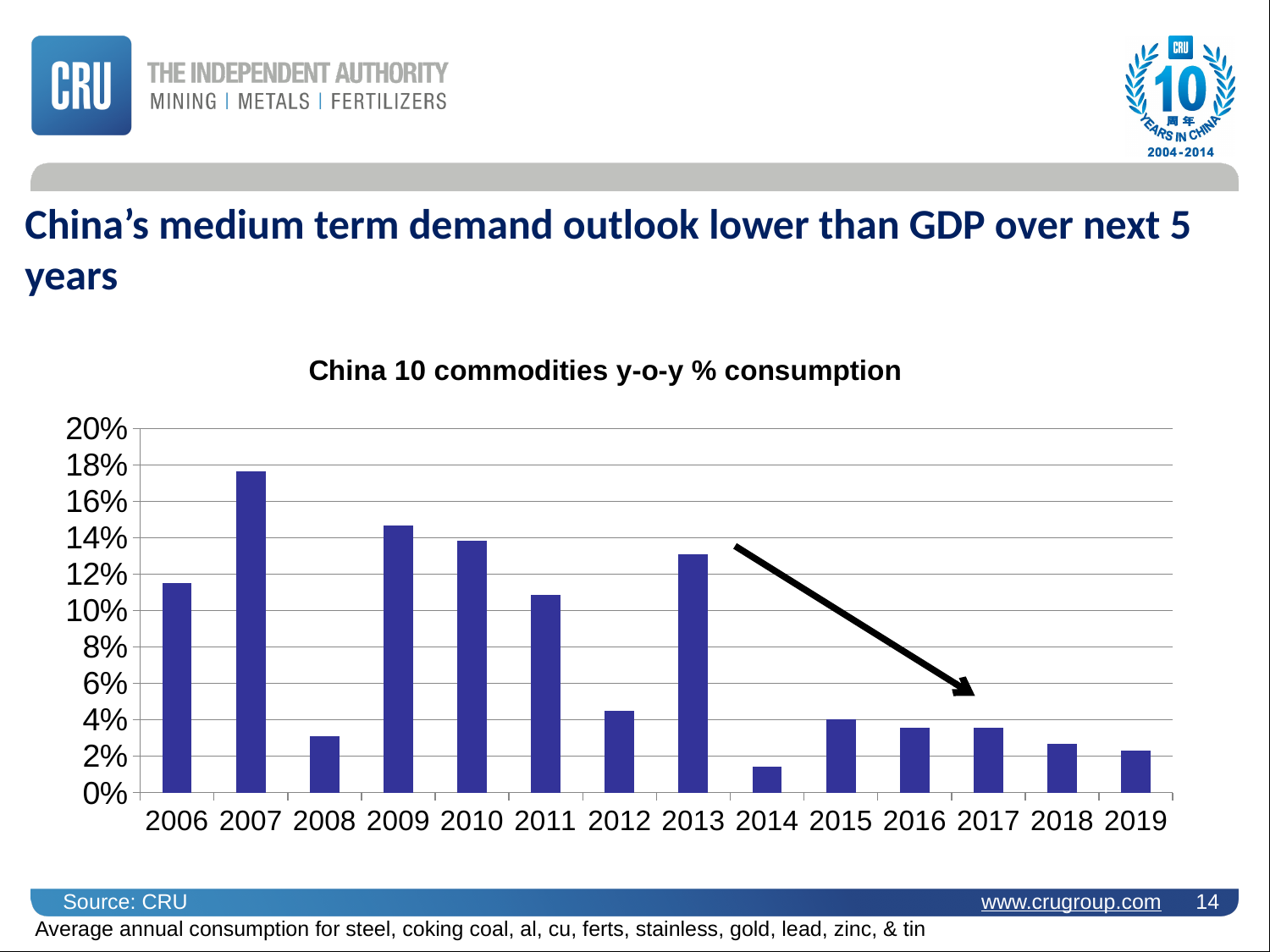
What kind of chart is shown on the slide? bar chart Is the value for 2006 greater or less than 10%? greater Do the values rise or fall from 2015 to 2019? fall Which year has the larger value, 2011 or 2012? 2011 Is the value for 2014 greater or less than 2%? less What is the title of the chart? China 10 commodities y-o-y % consumption Is the value for 2008 greater or less than 4%? less Which year has the lowest y-o-y % consumption growth? 2014 Which year has the highest y-o-y % consumption growth? 2007 How many years are plotted on the x axis of the chart? 14